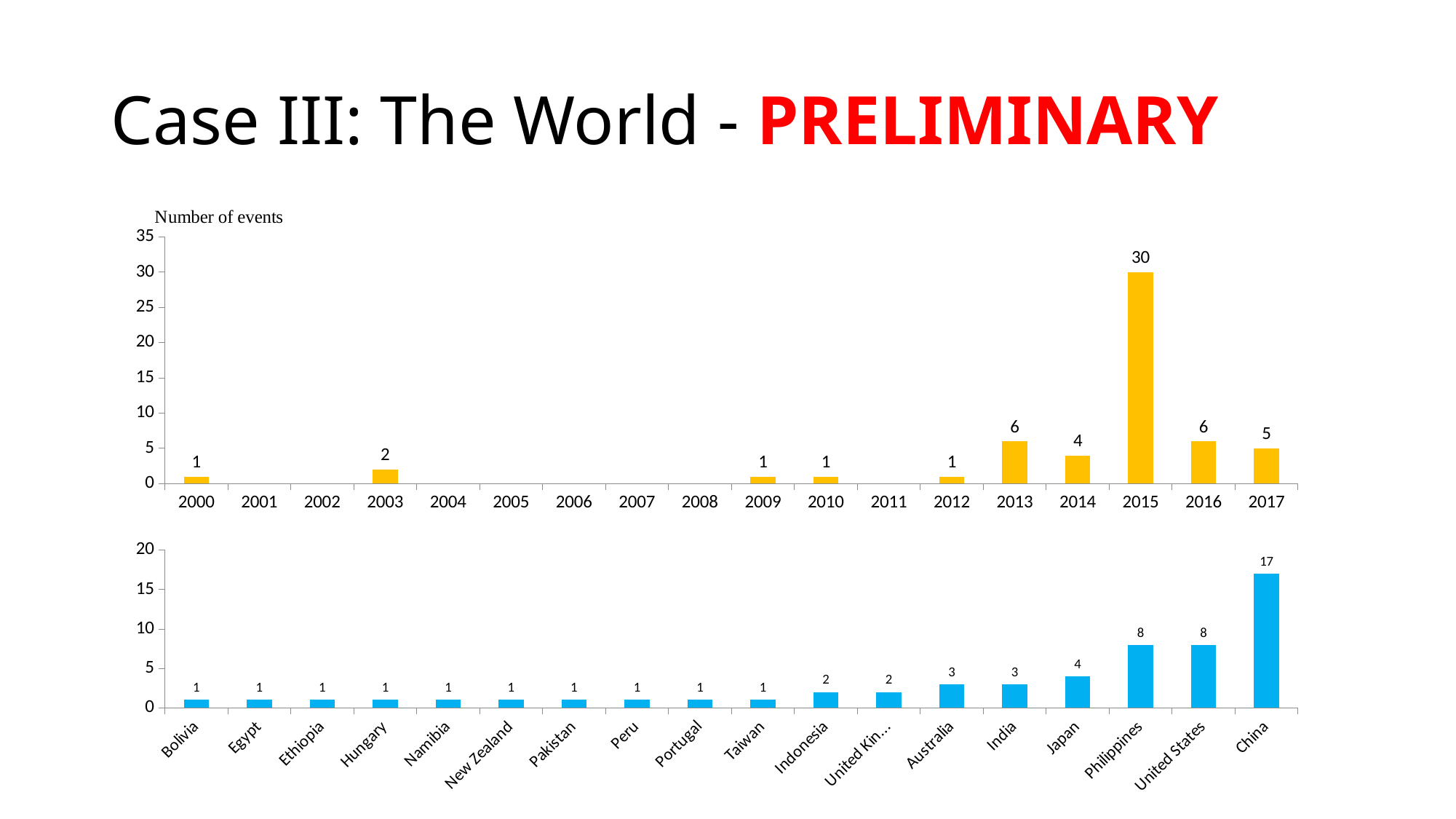
In the bottom chart (by country), how many countries are shown on the x axis? 18 In the top chart (by year), which year has the highest number of events? 2015 What type of chart is the bottom chart (by country)? Bar chart In the top chart (by year), what is the number of events in 2014? 4 In the bottom chart (by country), what is the difference between the values for China and Philippines? 9 In the top chart (by year), what is the difference between the number of events in 2015 and 2016? 24 In the top chart (by year), how many years are shown on the x axis? 18 In the top chart (by year), which is larger, the value for 2013 or the value for 2017? 2013 In the top chart (by year), what is the number of events in 2015? 30 In the bottom chart (by country), which country has the highest value? China In the bottom chart (by country), what is the value for Japan? 4 In the bottom chart (by country), what is the value for China? 17